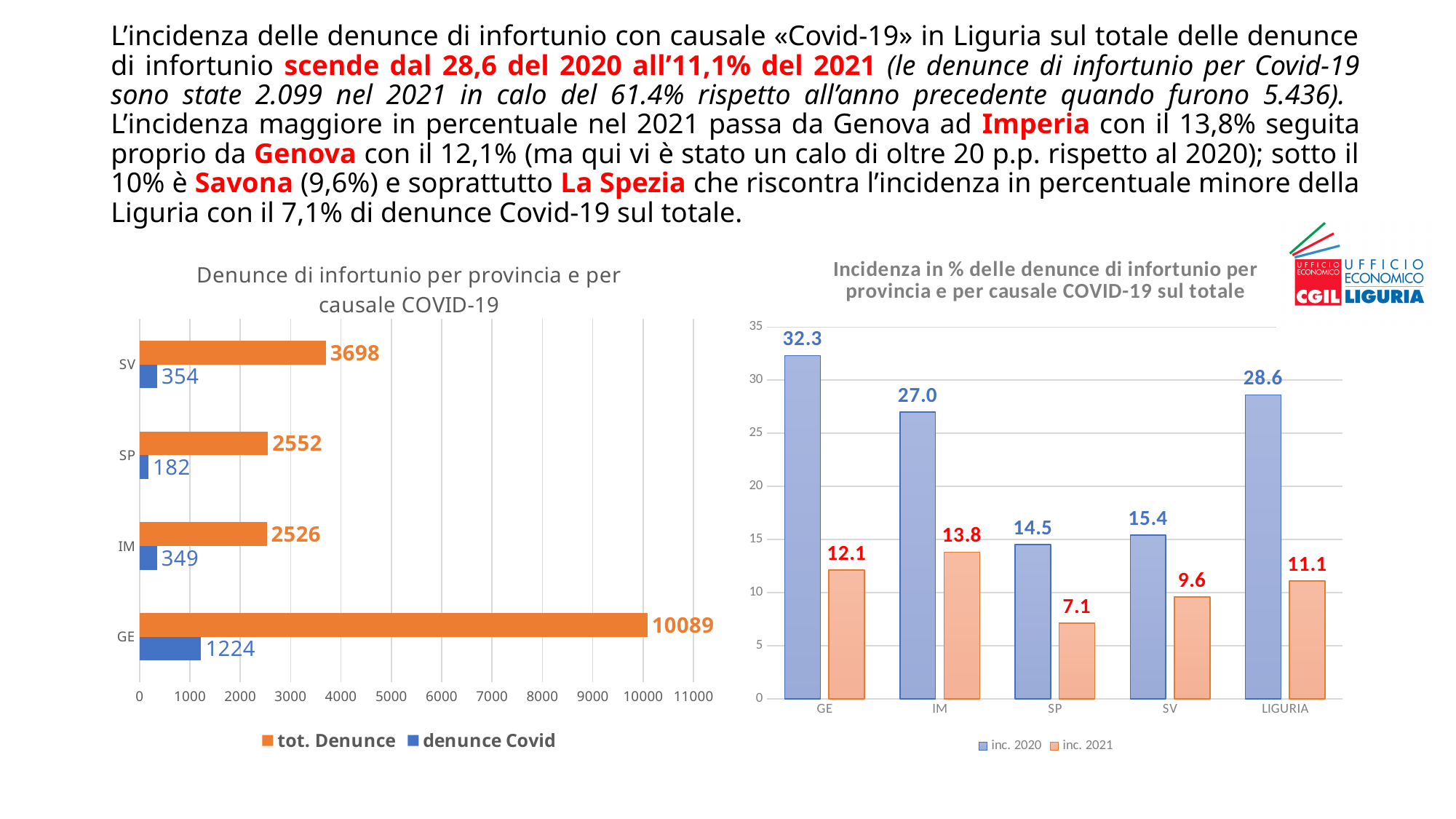
In the left chart (Denunce di infortunio per provincia e per causale COVID-19), how many provinces are shown? 4 In the right chart (Incidenza in % delle denunce di infortunio), which is larger: inc. 2021 for SV or inc. 2021 for SP? inc. 2021 for SV In the right chart (Incidenza in % delle denunce di infortunio), what is the value of inc. 2020 for LIGURIA? 28.6 What type of chart is the left chart (Denunce di infortunio per provincia e per causale COVID-19)? Bar chart In the right chart (Incidenza in % delle denunce di infortunio), which category has the highest value of inc. 2020? GE In the left chart (Denunce di infortunio per provincia e per causale COVID-19), which province has the lowest value of denunce Covid? SP In the right chart (Incidenza in % delle denunce di infortunio), what is the value of inc. 2021 for IM? 13.8 In the left chart (Denunce di infortunio per provincia e per causale COVID-19), what is the difference between tot. Denunce for SV and tot. Denunce for SP? 1146 In the left chart (Denunce di infortunio per provincia e per causale COVID-19), what is the value of tot. Denunce for GE? 10089 How many series does the legend of the right chart (Incidenza in % delle denunce di infortunio) list? 2 In the left chart (Denunce di infortunio per provincia e per causale COVID-19), what is the value of denunce Covid for SP? 182 In the right chart (Incidenza in % delle denunce di infortunio), what is the difference between inc. 2020 and inc. 2021 for GE? 20.2